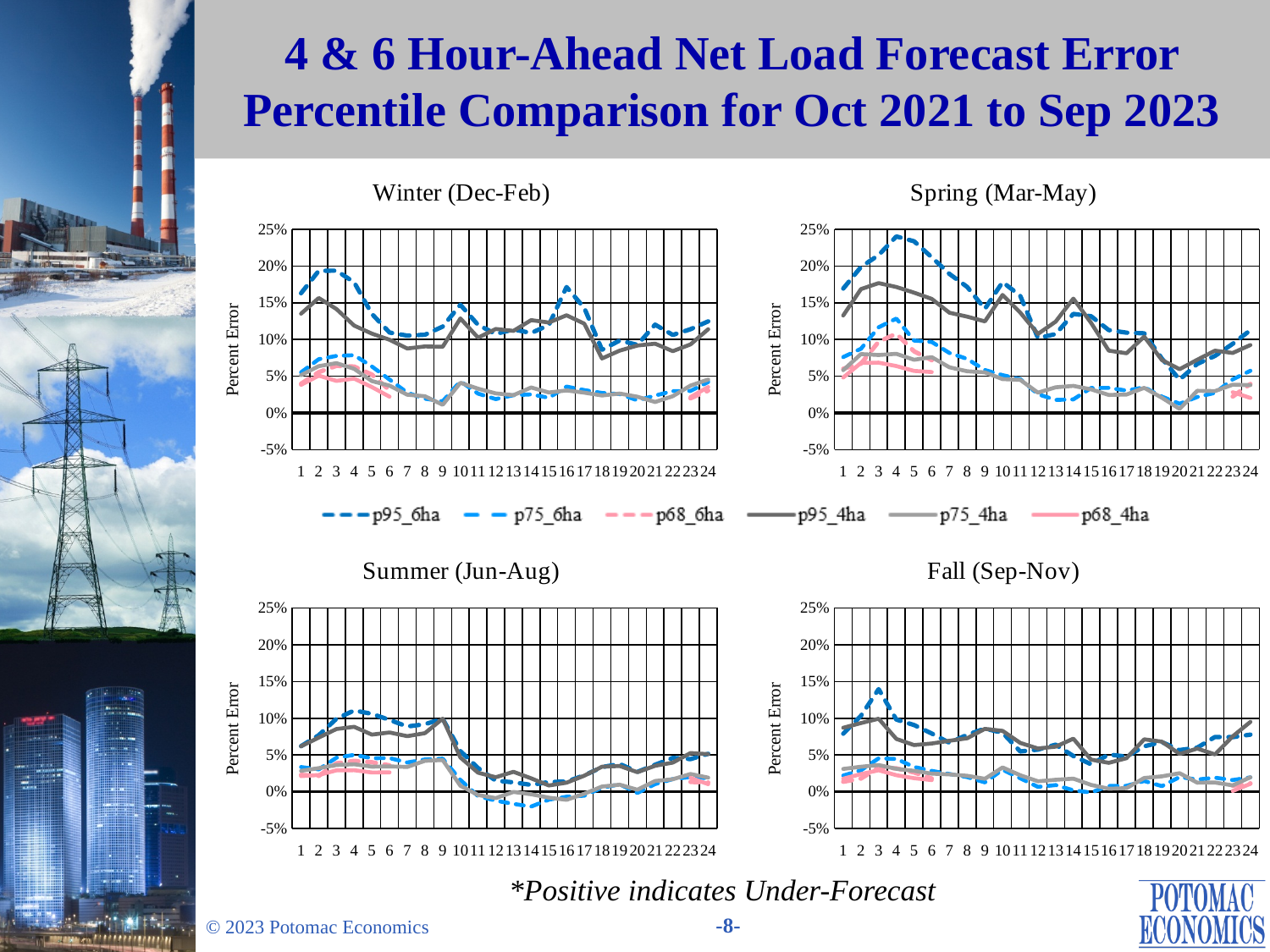
In the Fall (Sep-Nov) chart, is the p95_6ha value at hour 3 greater or less than 10%? greater How many hour points are plotted along the x axis of the Summer (Jun-Aug) chart? 24 In the Summer (Jun-Aug) chart, is the p95_6ha value at hour 1 greater or less than 10%? less According to the footnote, what does a positive value indicate? Under-Forecast In the Spring (Mar-May) chart, is the p95_6ha value at hour 4 greater or less than 20%? greater In the Spring (Mar-May) chart, does the p95_6ha line rise or fall from hour 4 to hour 8? fall Which seasonal chart shows the highest peak for the p95_6ha series? Spring (Mar-May) How many series does the legend list? 6 What kind of chart is used in the Winter (Dec-Feb) panel? Line chart What is the label on the vertical axis of each chart? Percent Error